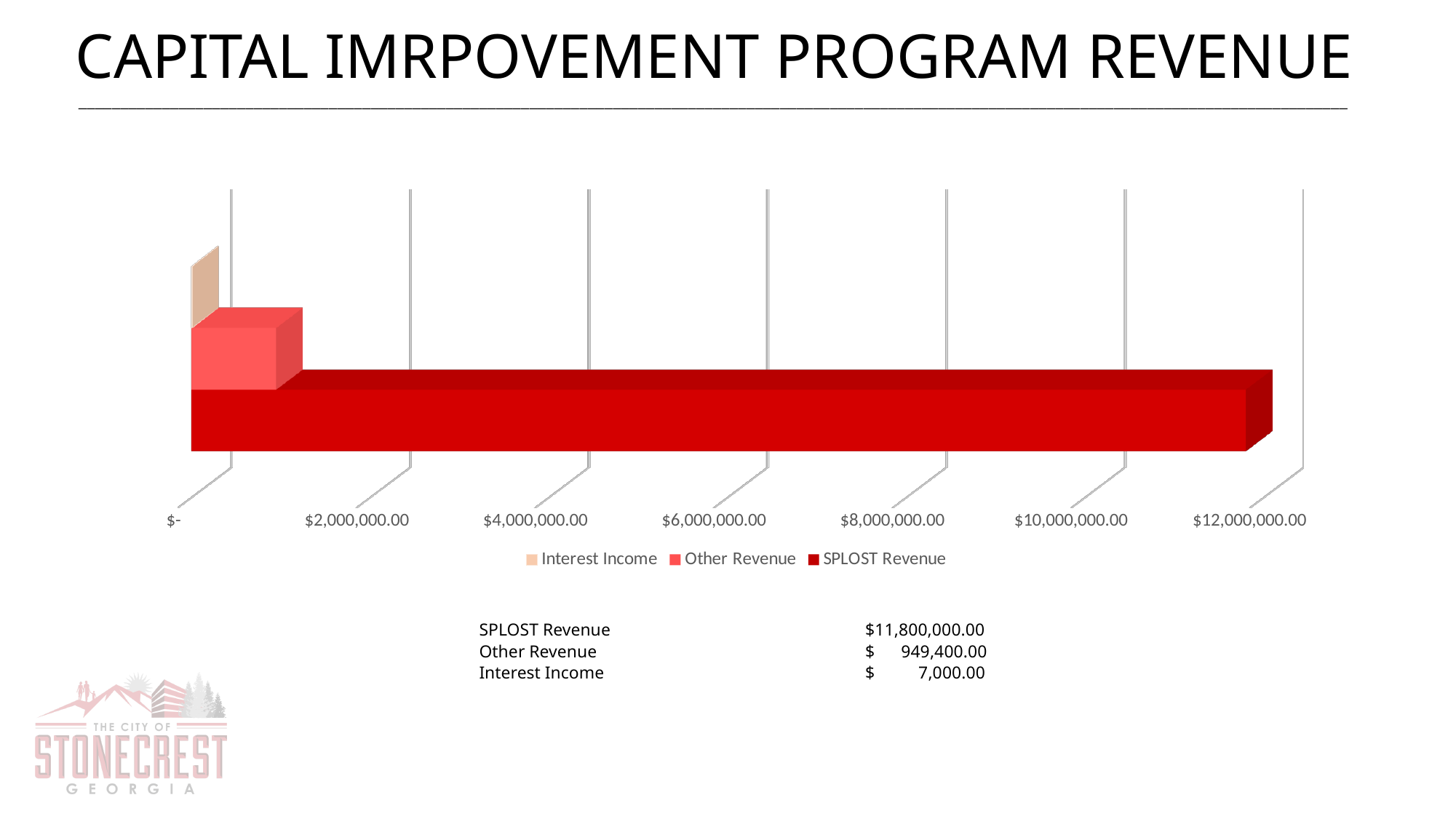
What kind of chart is shown on the slide? bar chart Is the value for SPLOST Revenue greater or less than $10,000,000.00? greater How many series does the chart legend list? 3 What is the value for Interest Income? $7,000.00 Is the value for Other Revenue greater or less than $2,000,000.00? less Which revenue source has the lowest value? Interest Income Which revenue source has the highest value? SPLOST Revenue What is the difference between SPLOST Revenue and Other Revenue? $10,850,600.00 What is the value for Other Revenue? $949,400.00 What is the title of the slide containing the chart? CAPITAL IMRPOVEMENT PROGRAM REVENUE Which is larger, Other Revenue or Interest Income? Other Revenue What is the value for SPLOST Revenue? $11,800,000.00